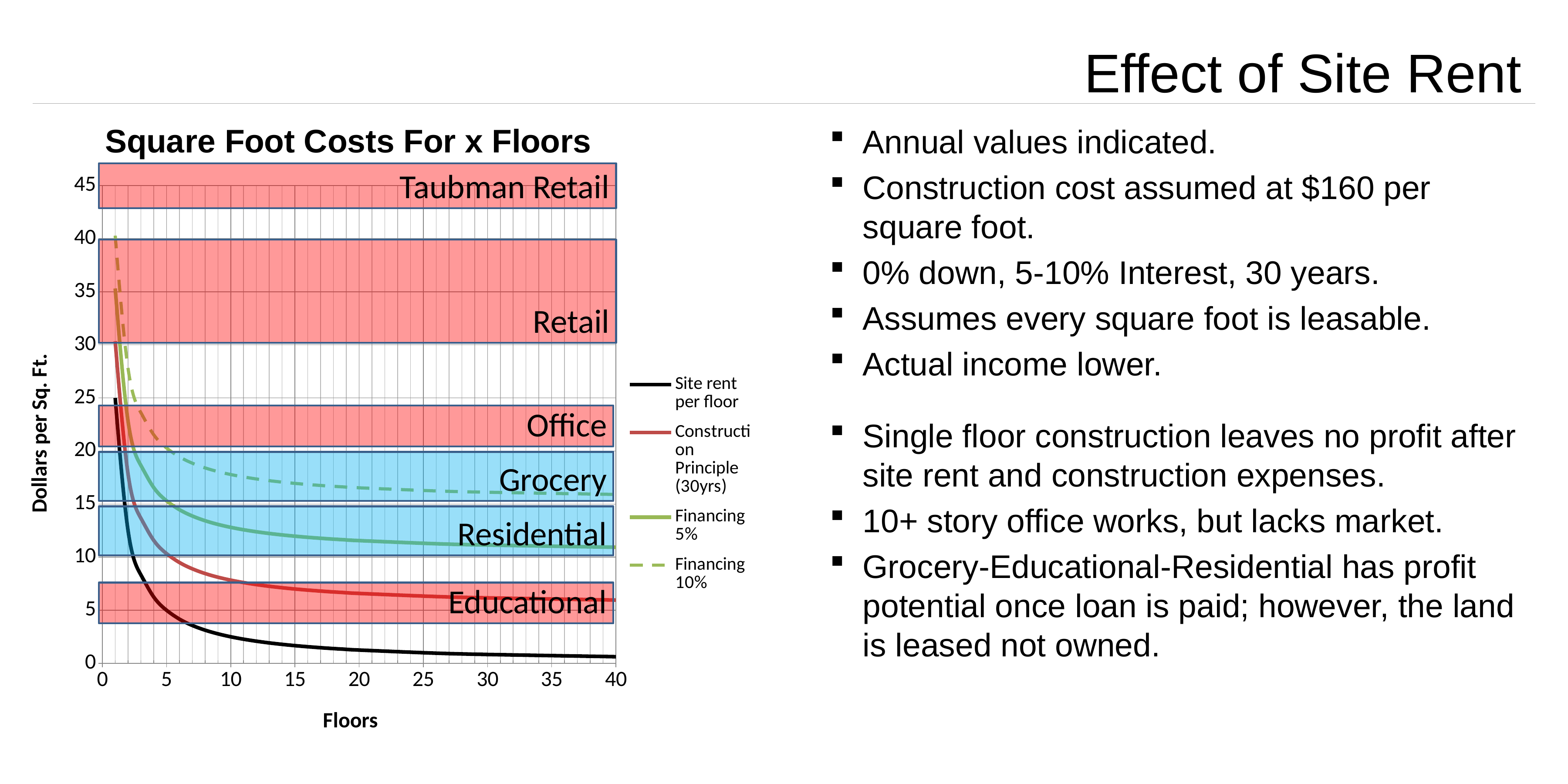
At 40 floors, which series has the highest value? Financing 10% At 40 floors, which series has the lowest value? Site rent per floor Is the value of Site rent per floor at 40 floors greater or less than 5? less What is the title of the chart? Square Foot Costs For x Floors Is the value of Financing 10% at 40 floors greater or less than 10? greater Does the Site rent per floor line rise or fall as the number of floors increases? Fall How many series does the chart legend list? 4 Which series in the legend is drawn as a dashed line? Financing 10% Does the Financing 10% line rise or fall as the number of floors increases? Fall At 40 floors, which is larger: Financing 10% or Financing 5%? Financing 10% Is the value of Construction Principle (30yrs) at 40 floors greater or less than 10? less What kind of chart is shown on the slide? Line chart